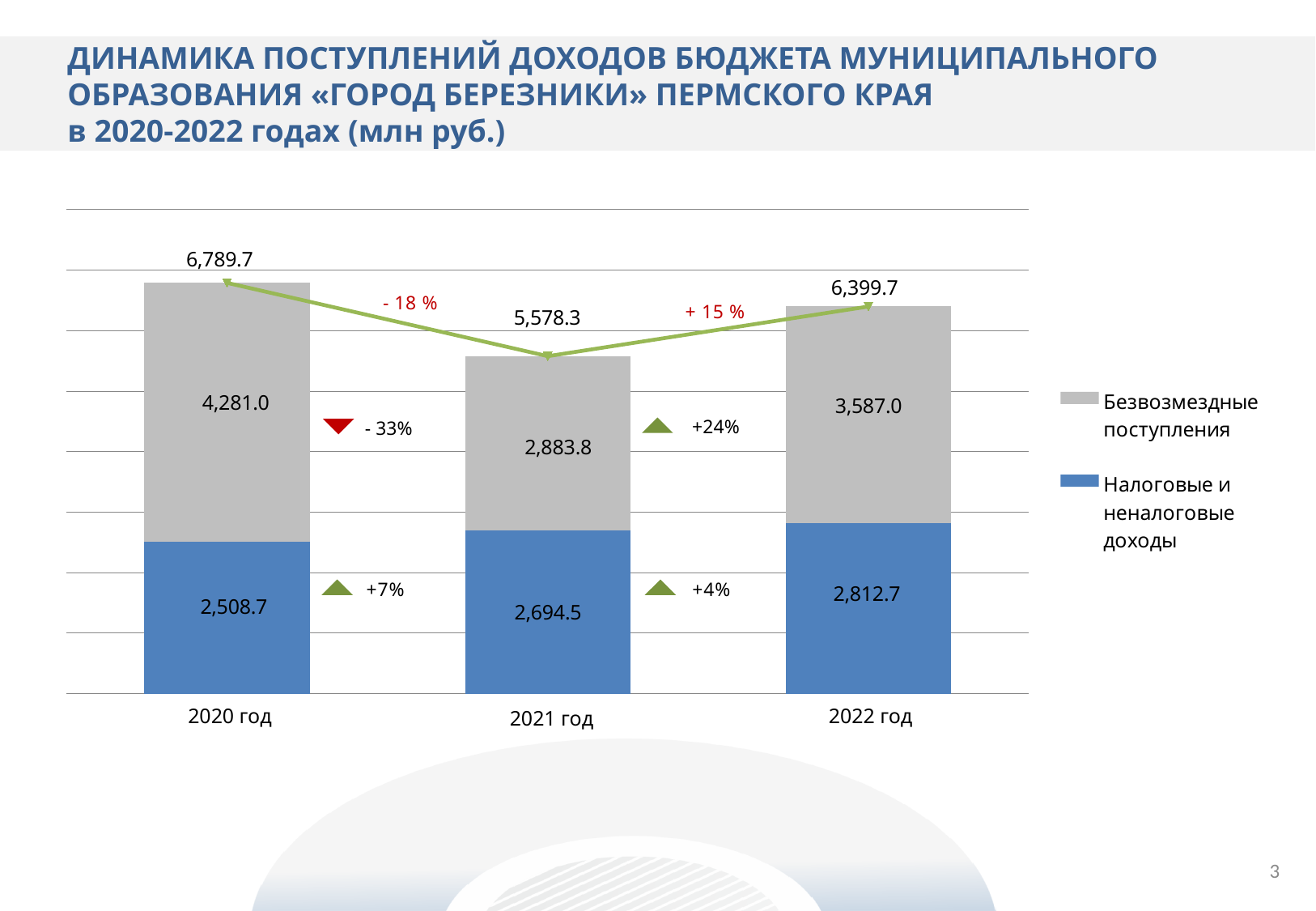
Which year has the lowest value for Безвозмездные поступления? 2021 год What is the value of Безвозмездные поступления for 2022 год? 3,587.0 Do the values for Налоговые и неналоговые доходы rise or fall from 2020 год to 2022 год? Rise How many series does the legend list? 2 What is the value of Безвозмездные поступления for 2021 год? 2,883.8 What is the difference between Налоговые и неналоговые доходы in 2022 год and in 2021 год? 118.2 Which is larger: Безвозмездные поступления in 2020 год or in 2022 год? 2020 год How many years (categories) are shown on the x axis? 3 What is the value of Налоговые и неналоговые доходы for 2020 год? 2,508.7 What is the total shown above the stacked bar for 2021 год? 5,578.3 What kind of chart is shown on the slide? Stacked bar chart combined with a line (showing totals) Which year has the highest total budget revenue? 2020 год